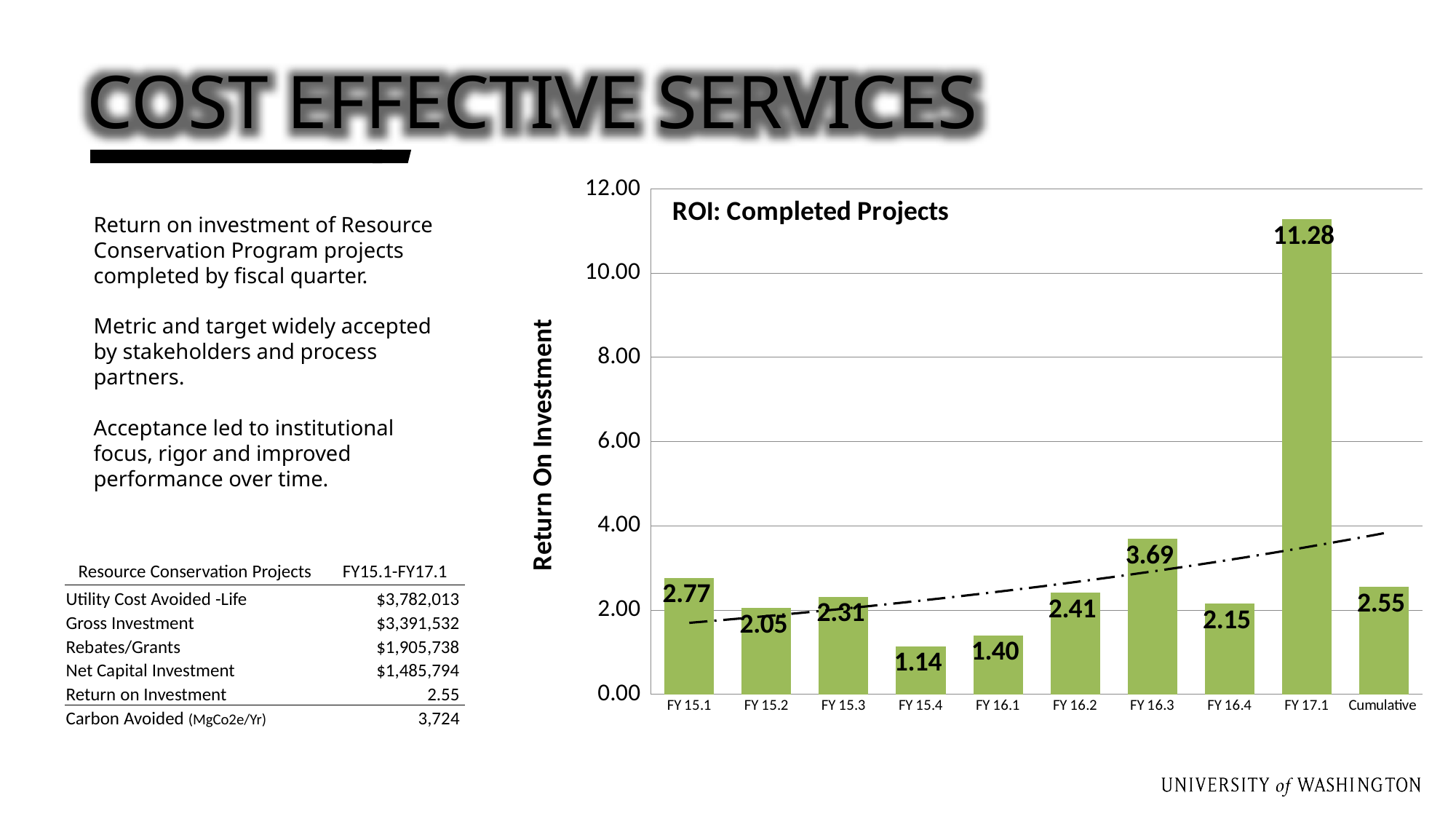
What is the difference between the ROI for FY 17.1 and FY 16.3? 7.59 What is the label on the vertical axis of the chart? Return On Investment Which fiscal quarter has the lowest ROI? FY 15.4 Which has a higher ROI, FY 15.1 or FY 16.2? FY 15.1 What is the ROI value for FY 15.4? 1.14 What is the title of the chart? ROI: Completed Projects How many bars are plotted in the chart? 10 What is the Cumulative ROI shown in the chart? 2.55 What kind of chart is shown? bar chart What is the ROI value for FY 17.1? 11.28 Which fiscal quarter has the highest ROI? FY 17.1 Is the ROI for FY 16.3 greater or less than 4.00? less